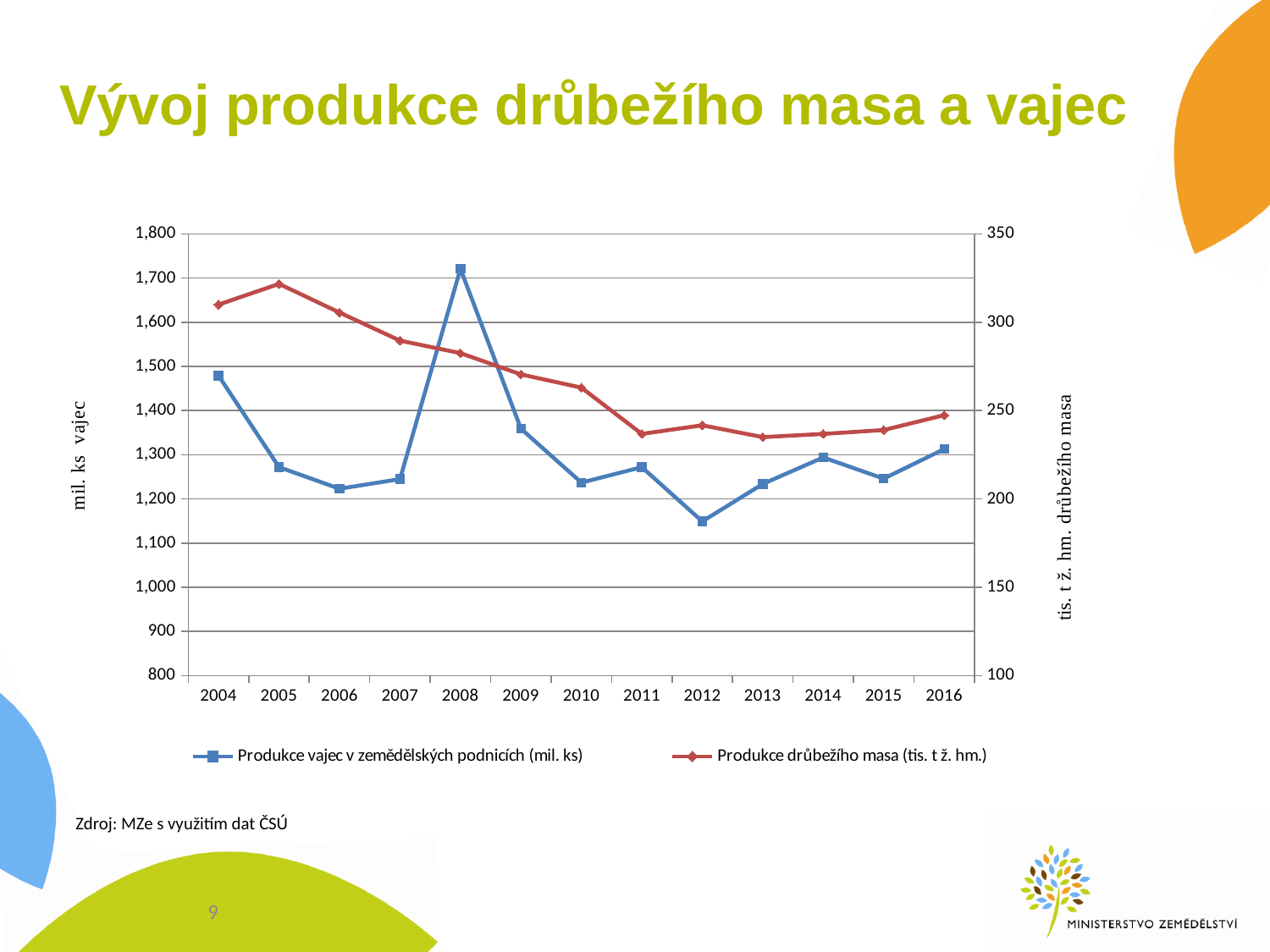
Is the value for 'Produkce vajec v zemědělských podnicích (mil. ks)' in 2008 greater or less than 1,700? greater In which year does the series 'Produkce vajec v zemědělských podnicích (mil. ks)' reach its lowest value? 2012 How many series does the legend list? 2 What kind of chart is shown on the slide? line chart Does the series 'Produkce drůbežího masa (tis. t ž. hm.)' generally rise or fall between 2005 and 2011? fall Is the value for 'Produkce drůbežího masa (tis. t ž. hm.)' in 2004 greater or less than 300? greater In which year does the series 'Produkce vajec v zemědělských podnicích (mil. ks)' reach its highest value? 2008 Is the value for 'Produkce vajec v zemědělských podnicích (mil. ks)' in 2012 greater or less than 1,200? less In which year does the series 'Produkce drůbežího masa (tis. t ž. hm.)' reach its highest value? 2005 How many years are plotted along the x axis? 13 What is the title of the slide containing the chart? Vývoj produkce drůbežího masa a vajec